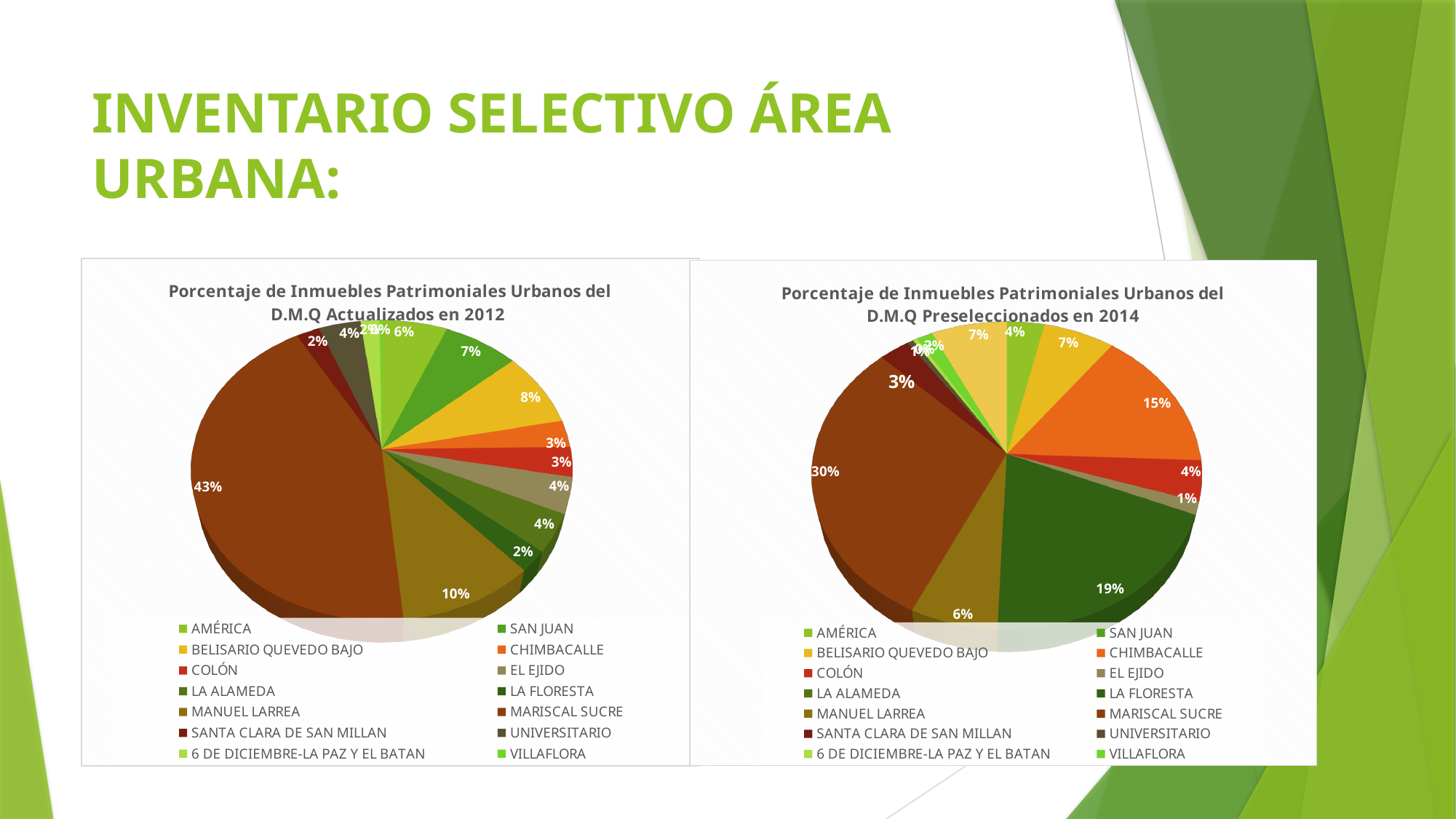
What is the title of the chart on the right? Porcentaje de Inmuebles Patrimoniales Urbanos del D.M.Q Preseleccionados en 2014 In the 2012 chart (left), what percentage does MANUEL LARREA represent? 10% In the 2012 chart (left), what percentage does MARISCAL SUCRE represent? 43% In the 2014 chart (right), what percentage does LA FLORESTA represent? 19% In the 2014 chart (right), what percentage does MARISCAL SUCRE represent? 30% In the 2014 chart (right), what is the share for CHIMBACALLE? 15% In the 2012 chart (left), what is the share for BELISARIO QUEVEDO BAJO? 8% How many categories does the legend of each chart list? 14 In the 2014 chart (right), which is larger, the share of LA FLORESTA or the share of CHIMBACALLE? LA FLORESTA In the 2012 chart (left), what is the difference between the shares of MARISCAL SUCRE and MANUEL LARREA? 33% In the 2012 chart (left), which category has the largest share? MARISCAL SUCRE What type of charts are shown on the slide? Pie charts